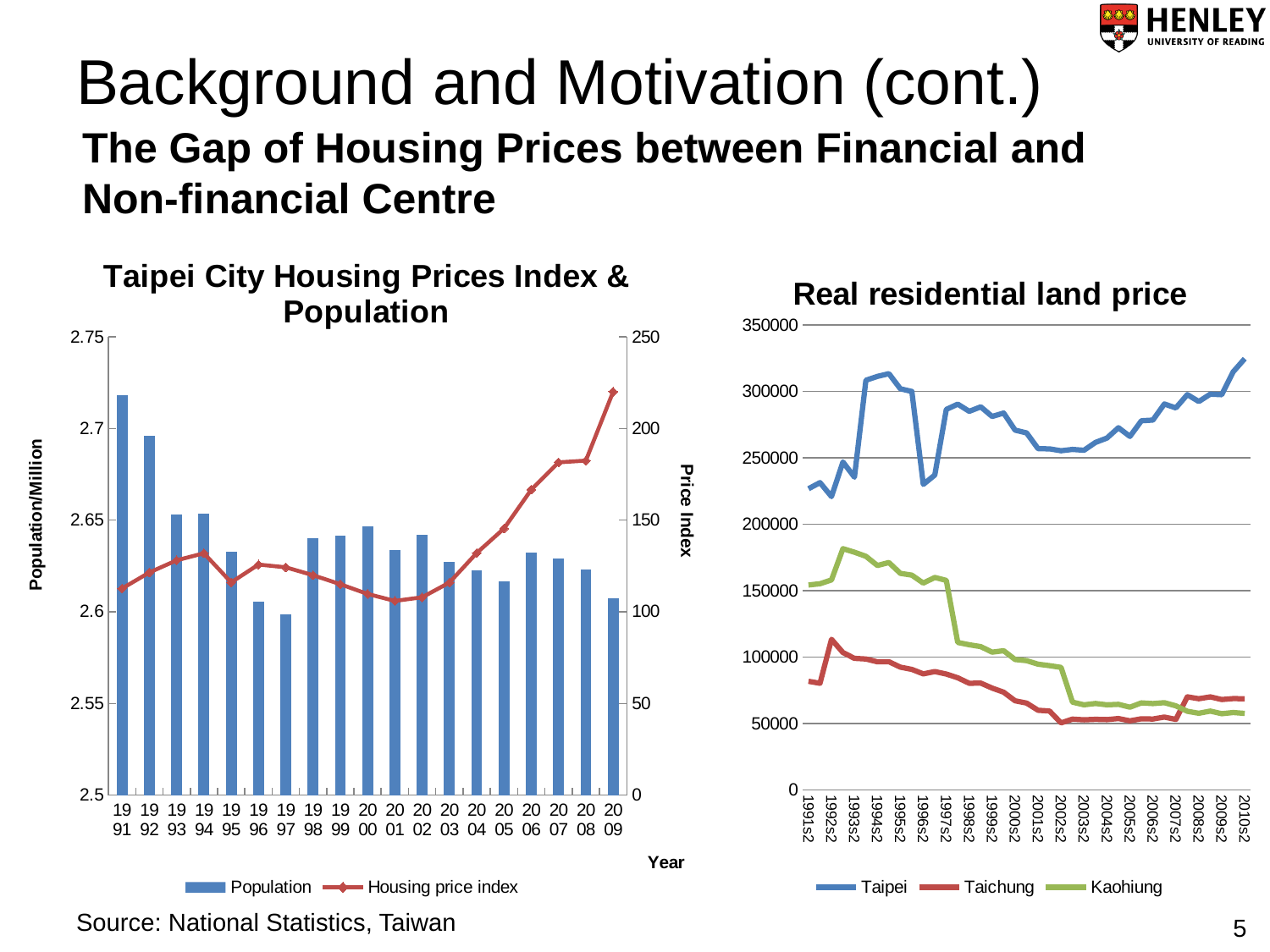
In the 'Real residential land price' chart, does the Taichung series rise or fall overall from 1992s2 to 2002s2? fall What kind of chart is the 'Real residential land price' chart? line chart In the 'Real residential land price' chart, is the Kaohiung value for 1993s2 greater or less than 150000? greater In the 'Real residential land price' chart, which is larger at 2010s2, Taipei or Kaohiung? Taipei How many series does the legend of the 'Real residential land price' chart list? 3 In the 'Real residential land price' chart, is the Taichung value for 2002s2 greater or less than 100000? less In the 'Taipei City Housing Prices Index & Population' chart, is the housing price index for 2009 greater or less than 200? greater In the 'Real residential land price' chart, which series has the highest values across the whole period? Taipei In the 'Taipei City Housing Prices Index & Population' chart, in which year is the housing price index highest? 2009 In the 'Taipei City Housing Prices Index & Population' chart, which year has the highest population bar? 1991 How many years are shown on the x axis of the 'Taipei City Housing Prices Index & Population' chart? 19